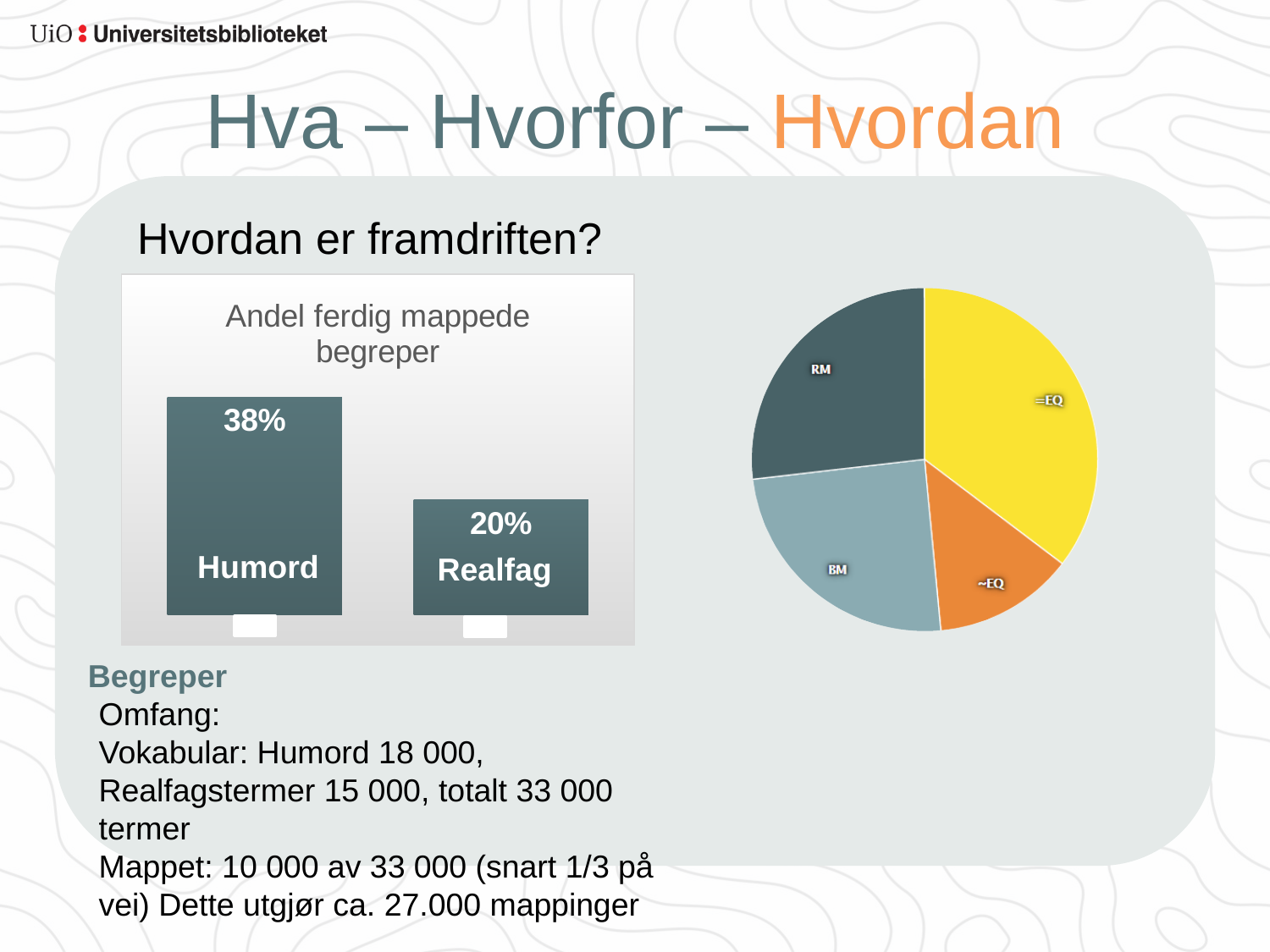
What is the title of the chart on the left side of the slide? Andel ferdig mappede begreper In the pie chart on the right side of the slide, which slice is the largest? =EQ How many slices does the pie chart on the right side of the slide have? 4 What kind of chart is the chart on the right side of the slide? Pie chart In the bar chart 'Andel ferdig mappede begreper', which is larger, the value for Humord or the value for Realfag? Humord How many categories are shown in the bar chart 'Andel ferdig mappede begreper'? 2 In the bar chart 'Andel ferdig mappede begreper', which category has the highest value? Humord In the bar chart 'Andel ferdig mappede begreper', what is the value for Realfag? 20% In the bar chart 'Andel ferdig mappede begreper', what is the difference between the values for Humord and Realfag? 18% In the bar chart 'Andel ferdig mappede begreper', which category has the lowest value? Realfag In the bar chart 'Andel ferdig mappede begreper', what is the value for Humord? 38% What kind of chart is the chart titled 'Andel ferdig mappede begreper'? Bar chart